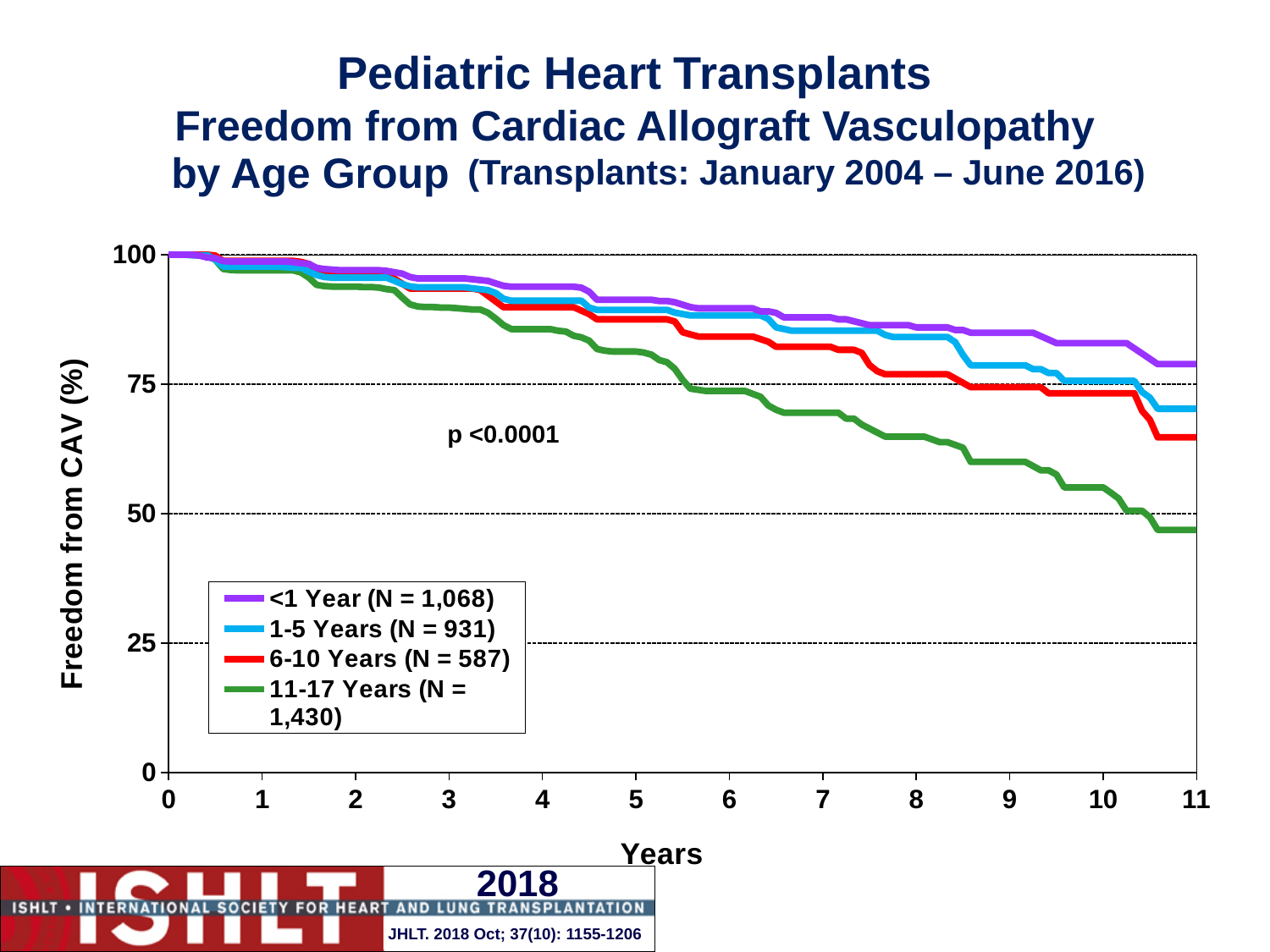
What p-value is printed on the chart? p <0.0001 Is the freedom from CAV for the 11-17 Years group at year 11 greater or less than 50? less Is the freedom from CAV for the <1 Year group at year 11 greater or less than 75? greater What is the freedom from CAV for all groups at year 0? 100 How many series does the legend list? 4 At year 8, which group has higher freedom from CAV: <1 Year or 11-17 Years? <1 Year What kind of chart is shown on the slide? line chart Do the freedom from CAV values rise or fall as years increase? fall Which age group has the lowest freedom from CAV at year 11? 11-17 Years Is the freedom from CAV for the 11-17 Years group at year 5 greater or less than 75? greater Which age group has the highest freedom from CAV at year 11? <1 Year